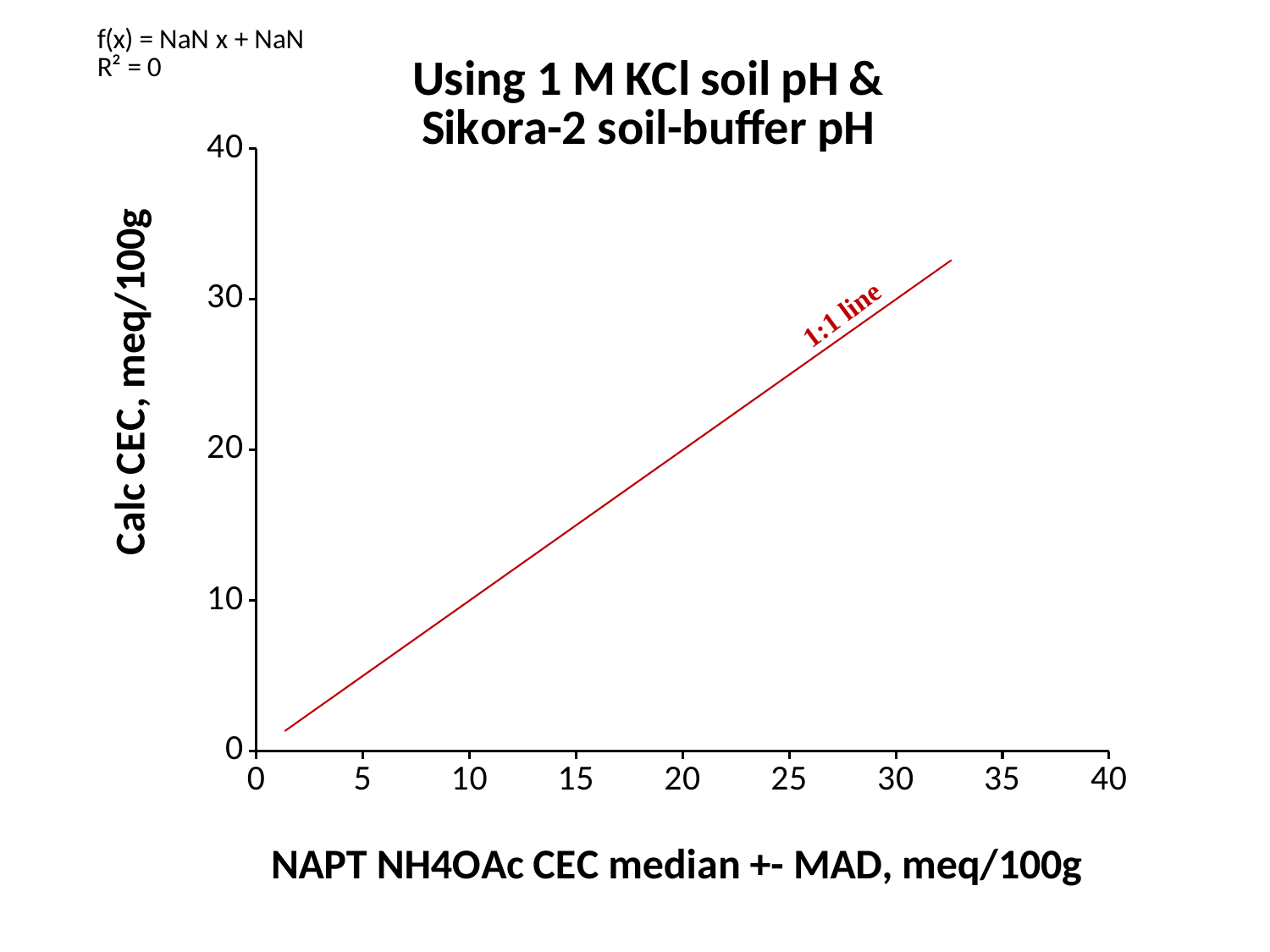
Does the red line rise or fall as the x-axis value increases? rises What is the label written along the red line? 1:1 line At an x value of 5, is the 1:1 line greater or less than 10? less What is the maximum value shown on the x axis? 40 At an x value of 30, is the 1:1 line greater or less than 20? greater What is the maximum value shown on the y axis? 40 How many lines are plotted on the chart? 1 What R-squared value is printed on the slide? R² = 0 What is the title of the chart? Using 1 M KCl soil pH & Sikora-2 soil-buffer pH What is the label of the y axis? Calc CEC, meq/100g What is the value of the 1:1 line at an x value of 20? 20 What kind of chart is shown on the slide? line chart